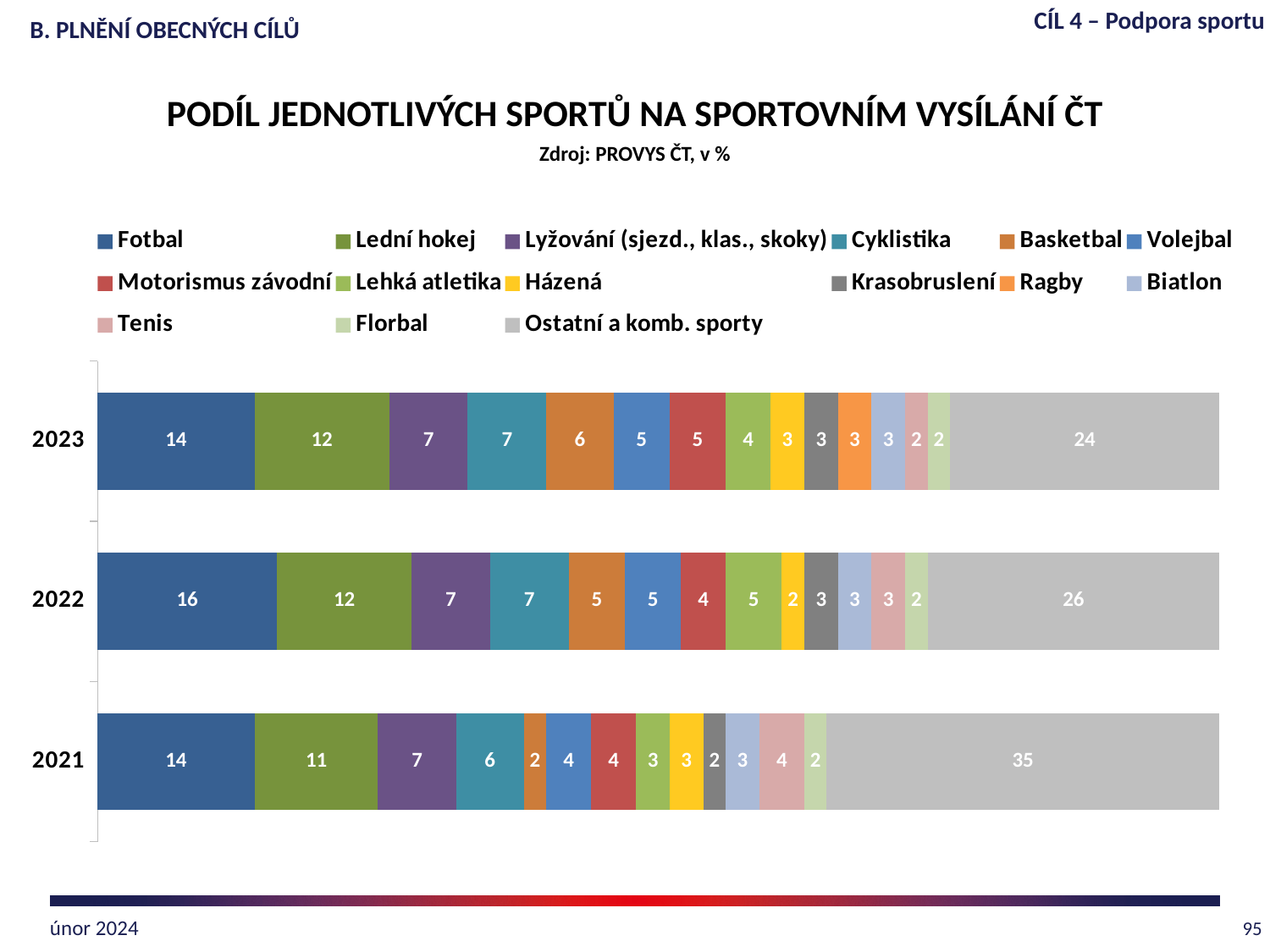
Which is larger: Lední hokej in 2023 or Lední hokej in 2021? Lední hokej in 2023 In which year is the Fotbal value the highest? 2022 What is the value for Ostatní a komb. sporty in 2021? 35 What is the title of the chart? PODÍL JEDNOTLIVÝCH SPORTŮ NA SPORTOVNÍM VYSÍLÁNÍ ČT What is the total of the stacked bar for 2023? 100 What is the value for Basketbal in 2021? 2 What kind of chart is shown on the slide? Stacked bar chart How many years are shown on the chart? 3 What is the difference between the Ostatní a komb. sporty values for 2021 and 2023? 11 What is the value for Fotbal in 2022? 16 In which year is the Ostatní a komb. sporty value the lowest? 2023 How many series does the legend list? 15